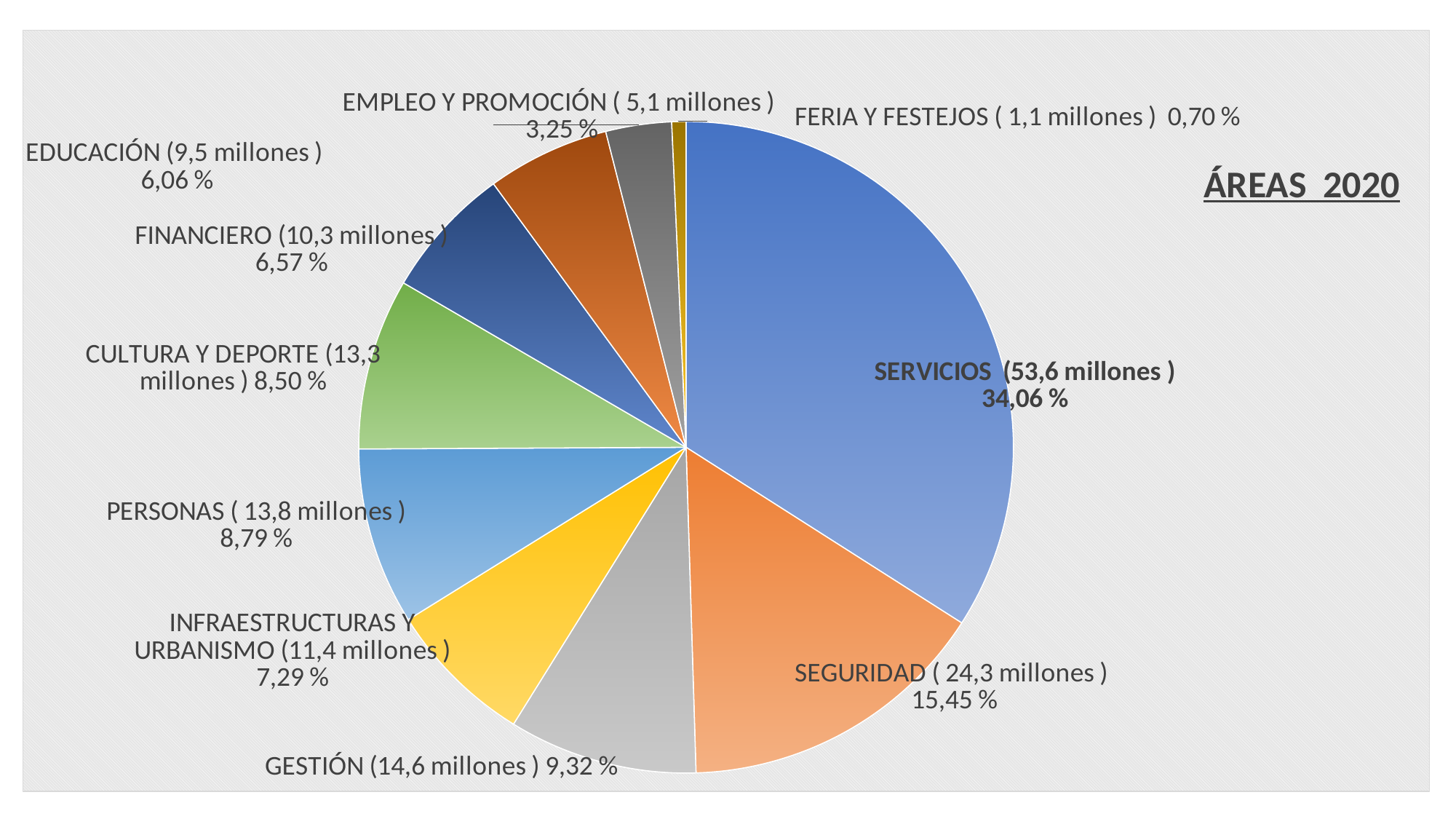
What amount in millions is shown for INFRAESTRUCTURAS Y URBANISMO? 11,4 millones What is the difference in percentage points between SERVICIOS (34,06 %) and SEGURIDAD (15,45 %)? 18,61 Which area has the largest share of the pie? SERVICIOS What kind of chart is shown on the slide? pie chart What is the title of the chart? ÁREAS 2020 How many slices does the pie chart have? 10 Which area has the smallest share of the pie? FERIA Y FESTEJOS Which has a larger share, PERSONAS or CULTURA Y DEPORTE? PERSONAS What percentage share does SERVICIOS have? 34,06 % What amount in millions is shown for SEGURIDAD? 24,3 millones What percentage share does GESTIÓN have? 9,32 % What percentage share does EMPLEO Y PROMOCIÓN have? 3,25 %